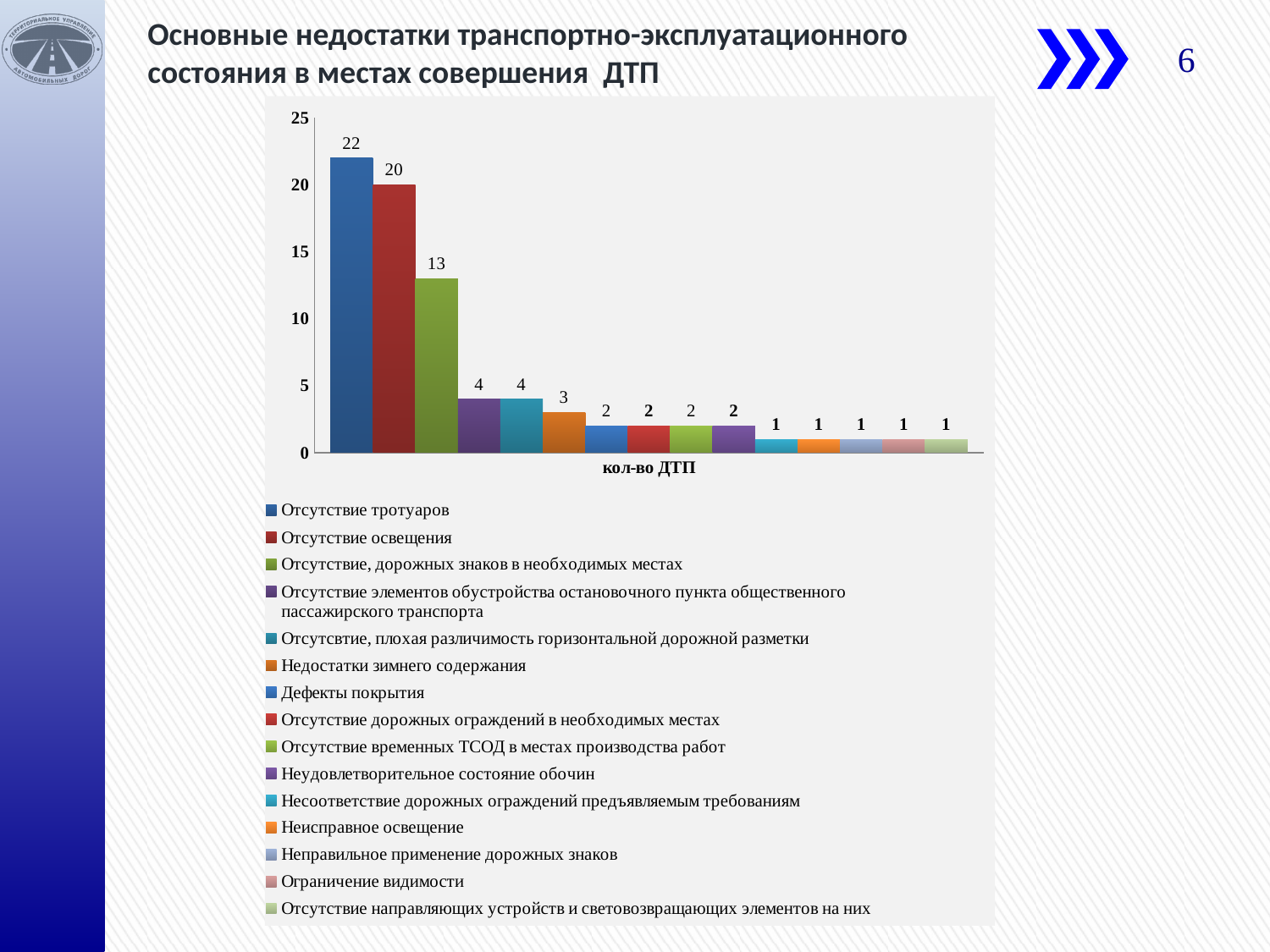
What is the value for "Отсутствие, дорожных знаков в необходимых местах"? 13 What is the difference between the values for "Отсутствие освещения" and "Отсутствие, дорожных знаков в необходимых местах"? 7 Which series has the highest value? Отсутствие тротуаров What is the value for "Отсутствие освещения"? 20 What is the difference between the values for "Отсутствие тротуаров" and "Отсутствие освещения"? 2 What type of chart is shown on the slide? Bar chart What is the value for "Отсутствие тротуаров"? 22 How many series does the legend list? 15 Which is larger, the value for "Отсутствие, дорожных знаков в необходимых местах" or the value for "Недостатки зимнего содержания"? Отсутствие, дорожных знаков в необходимых местах What label is shown on the horizontal axis of the chart? кол-во ДТП What is the value for "Недостатки зимнего содержания"? 3 How many bars are plotted in the chart? 15